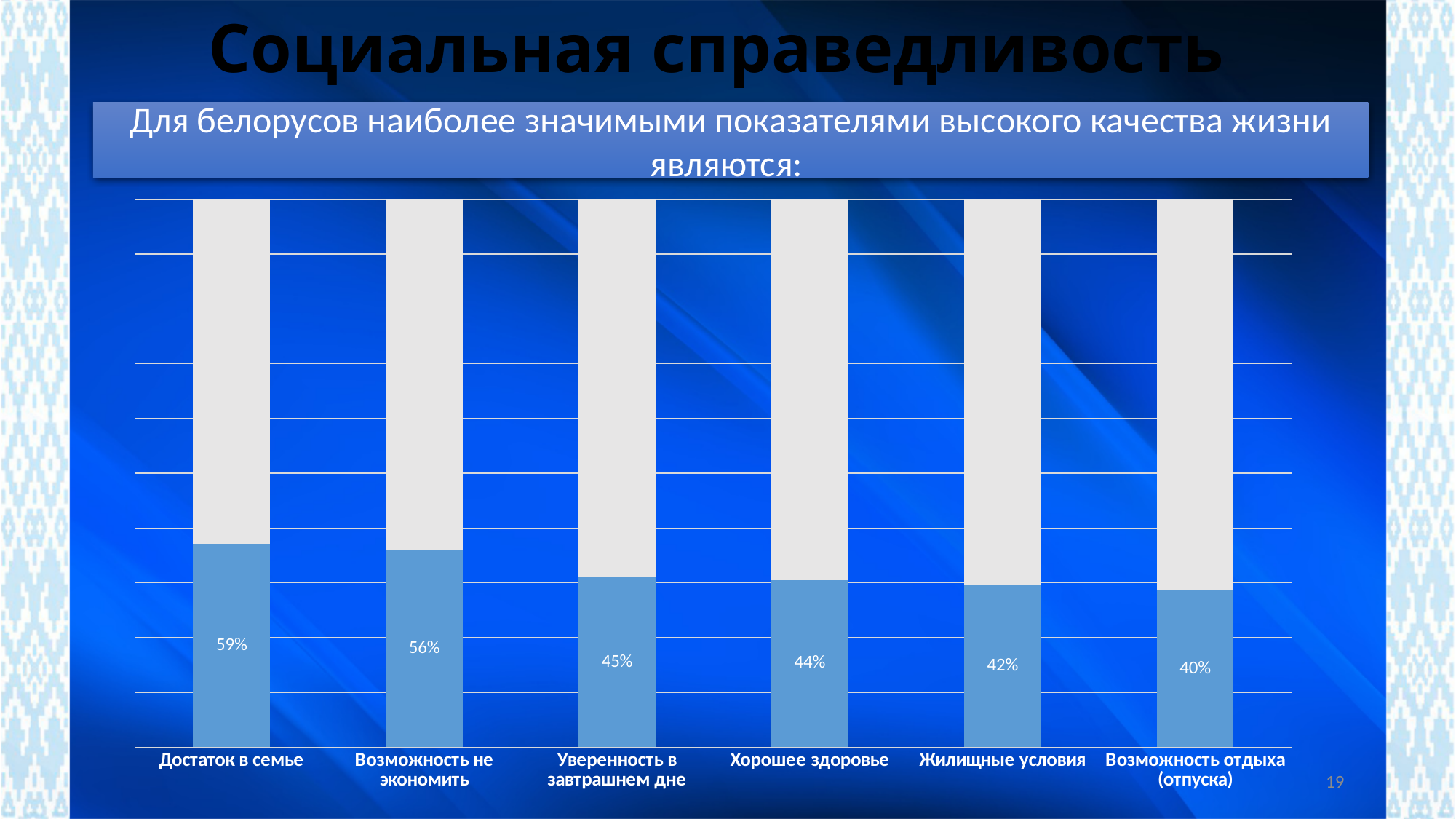
What value is shown for "Возможность не экономить"? 56% Which category has the lowest labelled value? Возможность отдыха (отпуска) Which is larger, the value for "Жилищные условия" or the value for "Возможность не экономить"? Возможность не экономить What kind of chart is shown on the slide? Bar chart Which category has the highest labelled value? Достаток в семье What value is shown for "Возможность отдыха (отпуска)"? 40% Do the labelled values rise or fall from left to right along the x axis? Fall How many categories are shown on the x axis? 6 What value is shown for "Достаток в семье"? 59% What value is shown for "Уверенность в завтрашнем дне"? 45% What is the difference between the values for "Достаток в семье" and "Возможность отдыха (отпуска)"? 19% What value is shown for "Хорошее здоровье"? 44%